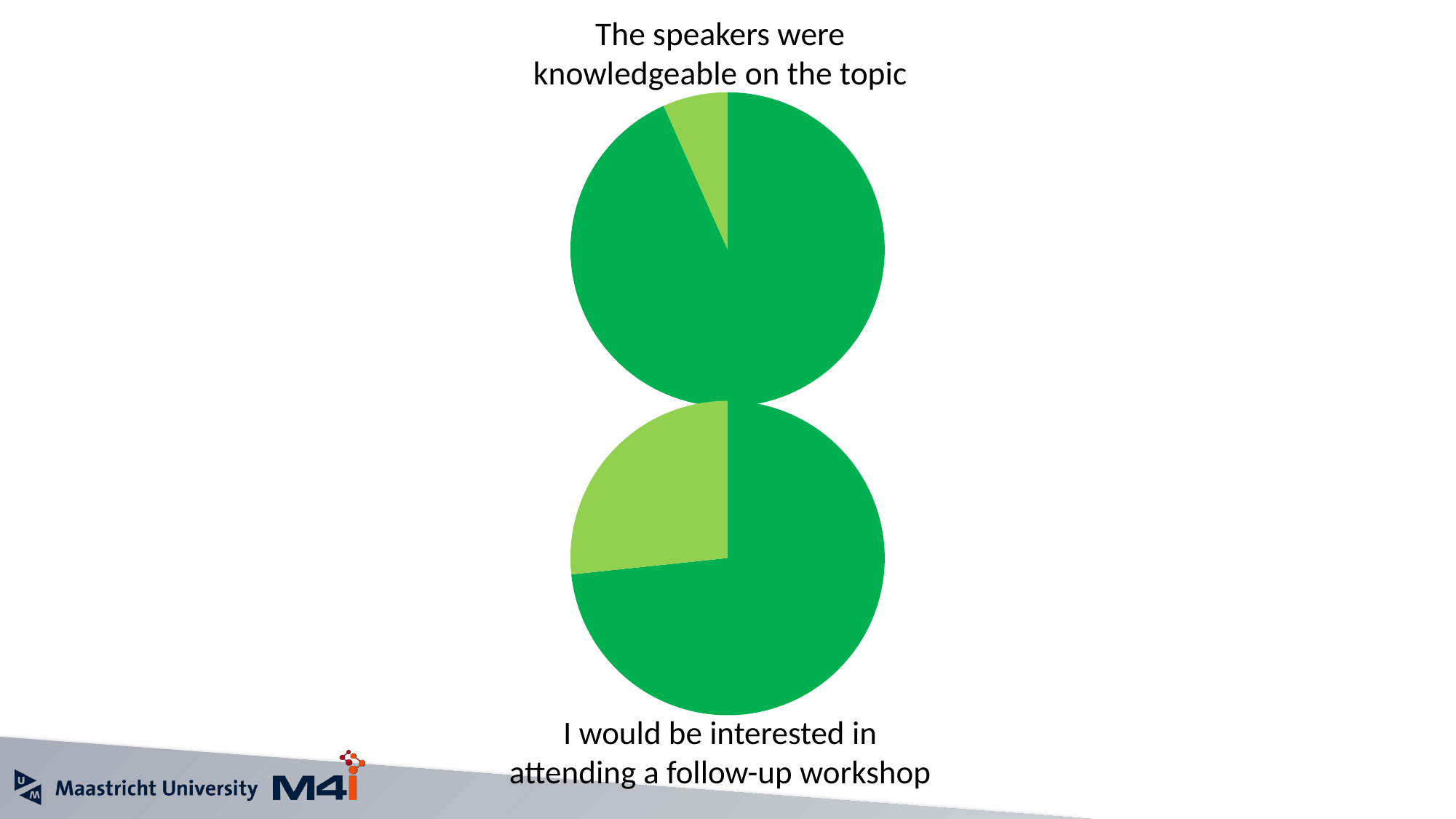
Which of the two pie charts has the larger light green slice? I would be interested in attending a follow-up workshop How many slices does the pie chart titled "The speakers were knowledgeable on the topic" have? 2 Which of the two pie charts has the larger dark green slice? The speakers were knowledgeable on the topic In the pie chart titled "The speakers were knowledgeable on the topic", which slice is larger, the dark green one or the light green one? the dark green one What kind of chart is the chart titled "The speakers were knowledgeable on the topic"? pie chart What kind of chart is the chart titled "I would be interested in attending a follow-up workshop"? pie chart What is the title of the lower pie chart on the slide? I would be interested in attending a follow-up workshop What is the title of the upper pie chart on the slide? The speakers were knowledgeable on the topic How many slices does the pie chart titled "I would be interested in attending a follow-up workshop" have? 2